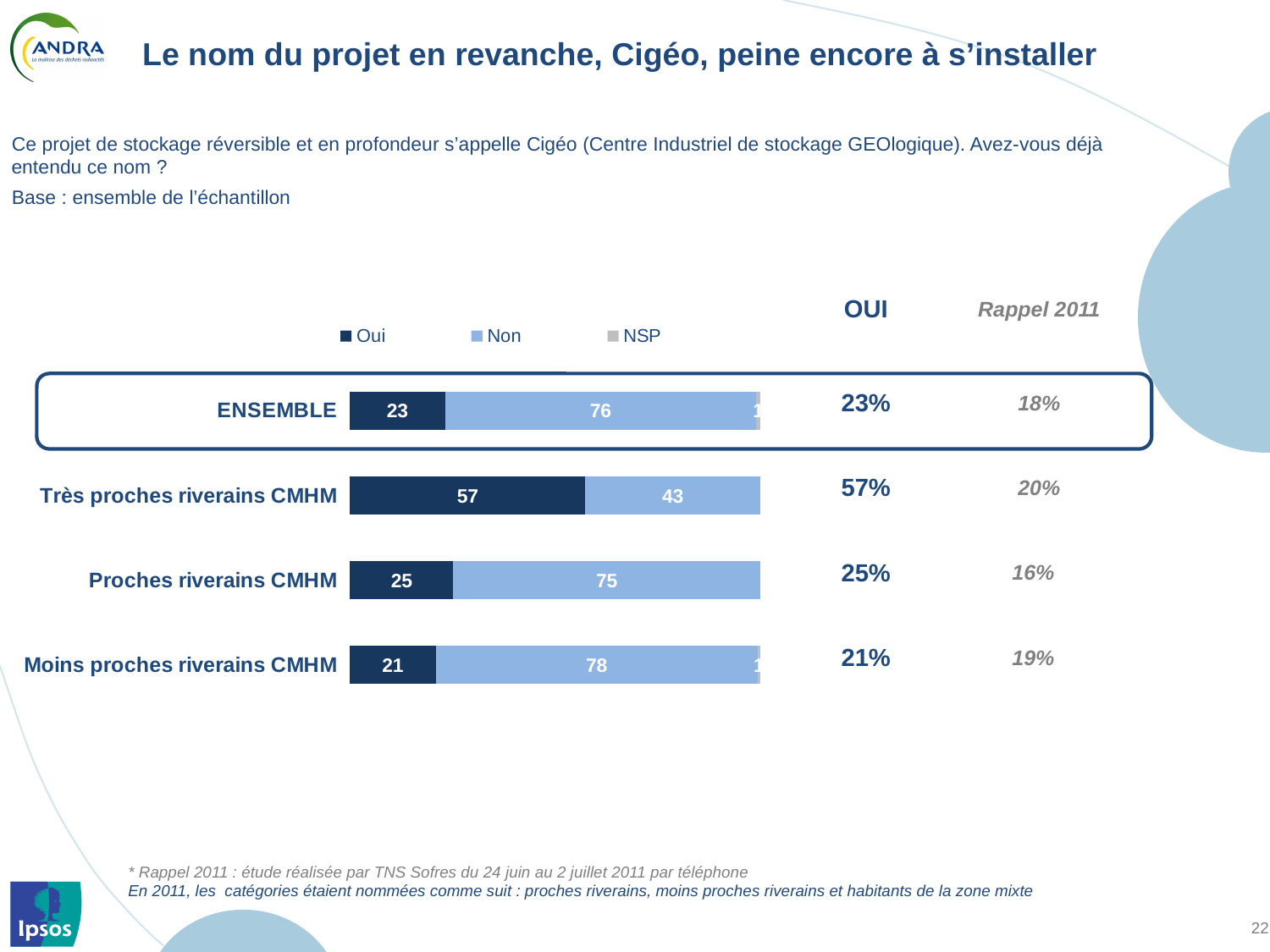
What is the 'Oui' value for 'Très proches riverains CMHM'? 57 What is the 'Rappel 2011' value shown for 'Très proches riverains CMHM'? 20% Which legend entry is shown in the darkest blue colour? Oui What kind of chart is shown on the slide? Stacked bar chart Which category has the lowest 'Oui' value? Moins proches riverains CMHM What is the 'Non' value for 'Moins proches riverains CMHM'? 78 How many categories are plotted in the chart? 4 What is the difference between the 'Oui' values for 'Très proches riverains CMHM' and 'Proches riverains CMHM'? 32 How many series does the legend list? 3 What is the 'Non' value for 'ENSEMBLE'? 76 Which is larger: the 'Non' value for 'Proches riverains CMHM' or the 'Non' value for 'Très proches riverains CMHM'? Proches riverains CMHM Which category has the highest 'Oui' value? Très proches riverains CMHM